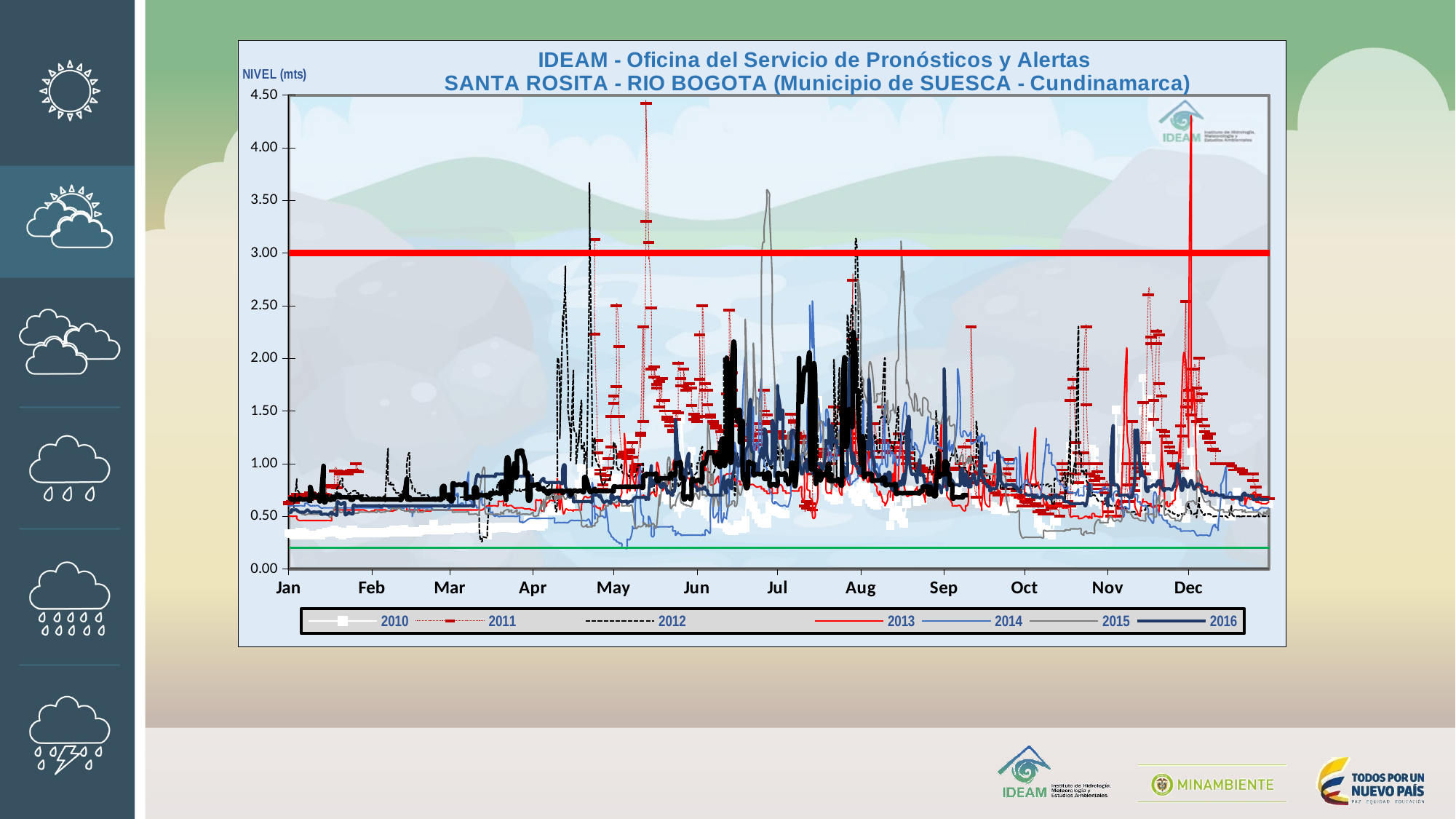
Is the peak value of the 2011 series in May greater or less than 4.00? greater Is the peak value of the 2012 series in late April greater or less than 3.00? greater What kind of chart is shown on the slide? line chart Is the value of the 2010 series in January greater or less than 0.50? less How many series does the legend list? 7 At what level is the thick red horizontal line drawn? 3.00 How many months are labelled along the x axis? 12 What is the label of the y axis? NIVEL (mts) What is the highest value shown on the y axis? 4.50